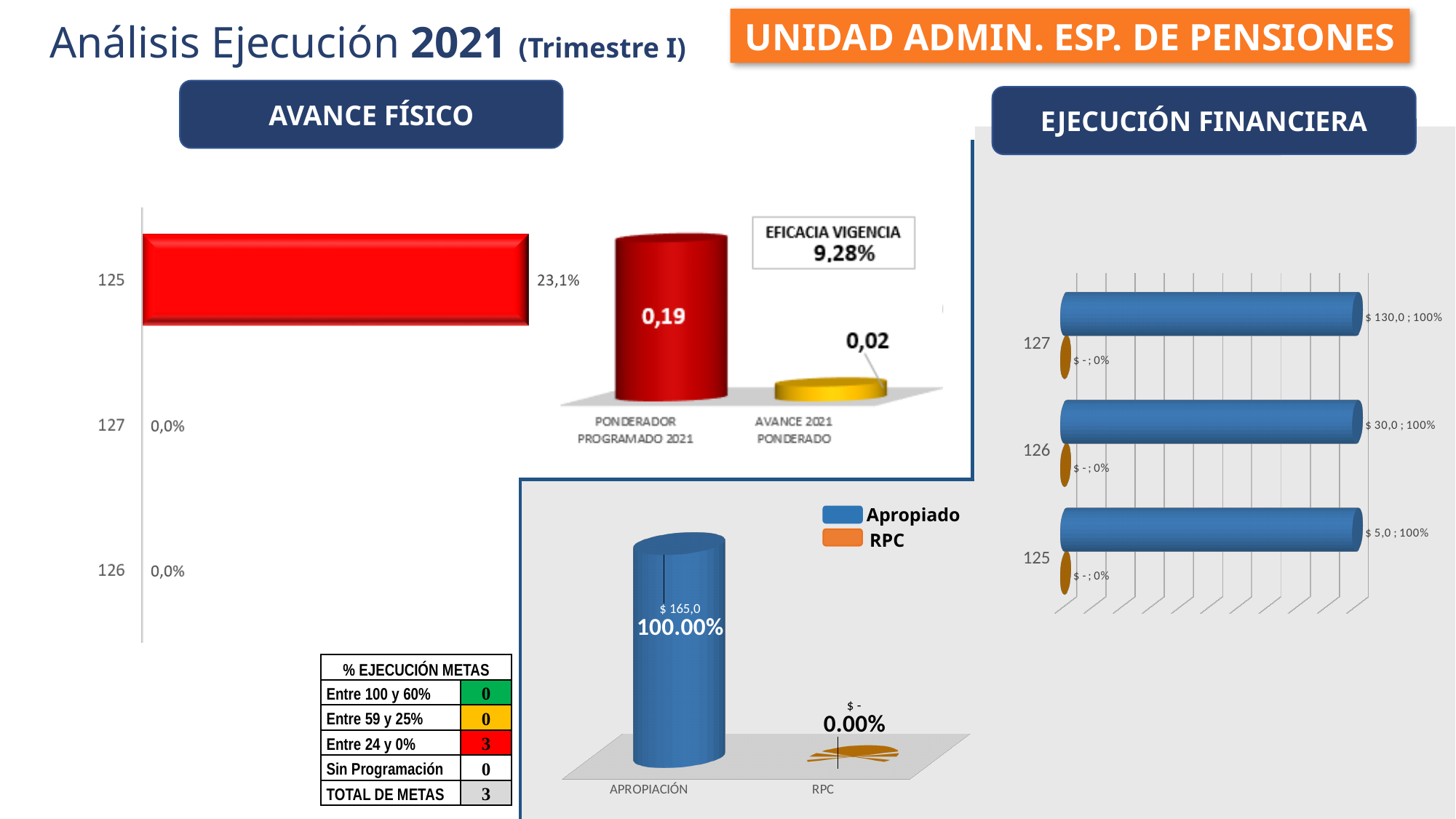
In the cylinder chart with the Eficacia Vigencia label, what is the value for Ponderador Programado 2021? 0,19 In the cylinder chart with the Eficacia Vigencia label, what is the difference between Ponderador Programado 2021 and Avance 2021 Ponderado? 0,17 In the bottom-centre chart with the Apropiado/RPC legend, what percentage is shown for RPC? 0.00% In the bottom-centre chart with the Apropiado/RPC legend, what is the value shown for Apropiación? $ 165,0 In the Avance Físico horizontal bar chart on the left, how many categories are shown? 3 How many series does the legend of the bottom-centre chart list? 2 In the Avance Físico horizontal bar chart on the left, which category has the highest value? 125 In the Avance Físico horizontal bar chart on the left, what is the value for category 125? 23,1% In the cylinder chart with the Eficacia Vigencia label, what is the value for Avance 2021 Ponderado? 0,02 In the Ejecución Financiera chart on the right, what is the Apropiado value for category 127? $ 130,0 In the Ejecución Financiera chart on the right, which category has the lowest Apropiado value? 125 In the Avance Físico horizontal bar chart on the left, what is the value for category 127? 0,0%